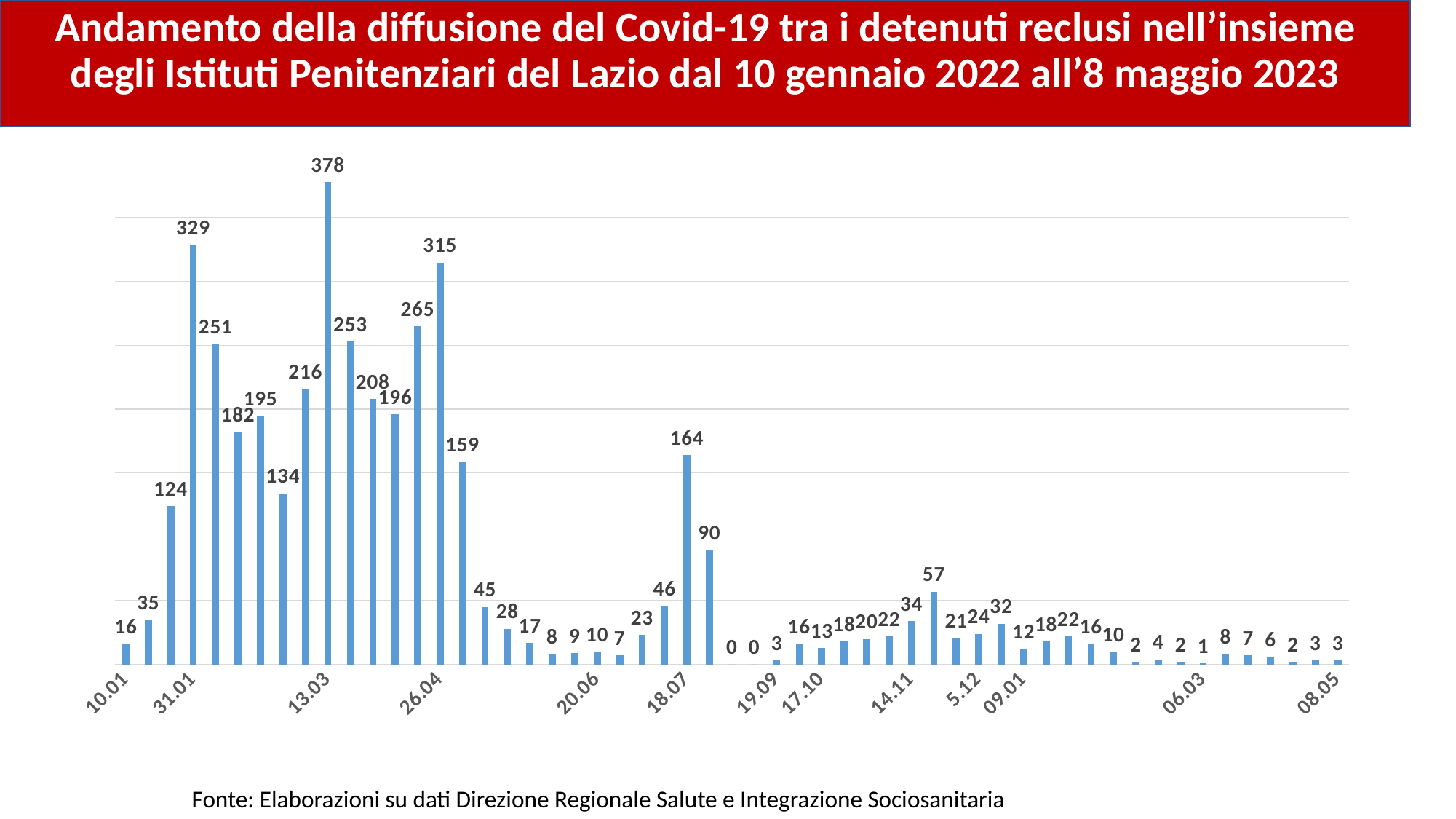
What is the difference between the values for 13.03 and 31.01? 49 What is the value for 26.04? 315 What is the value for 10.01? 16 Which date has the highest value in the chart? 13.03 According to the note below the chart, what is the source of the data? Elaborazioni su dati Direzione Regionale Salute e Integrazione Sociosanitaria What is the lowest value printed on any bar in the chart? 0 Which is larger, the value for 13.03 or the value for 26.04? 13.03 Overall, do the values rise or fall from 13.03 to 08.05? fall What kind of chart is shown on the slide? bar chart What is the value for 31.01? 329 What is the value for 13.03? 378 What is the value for 08.05, the last date on the x axis? 3